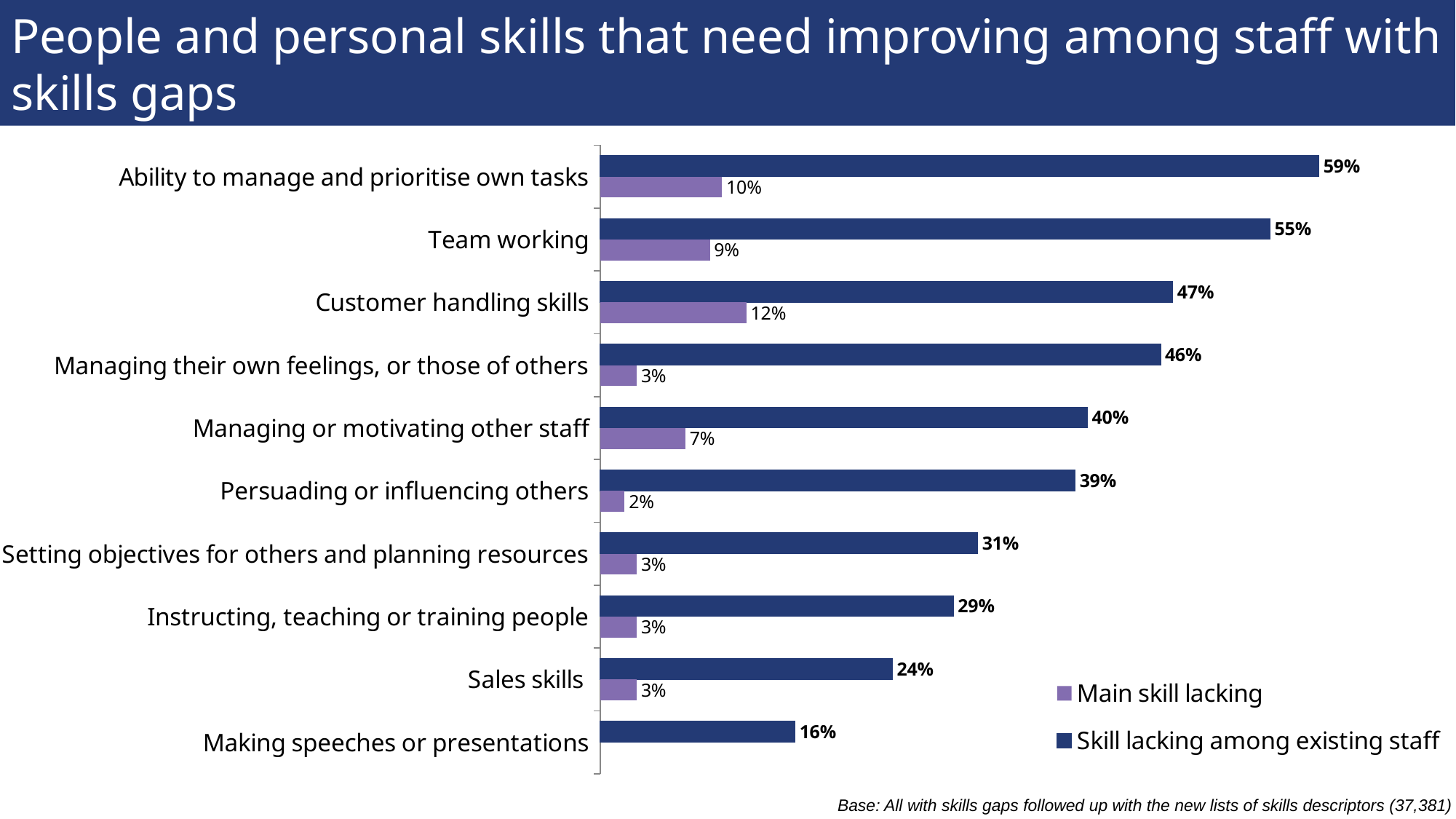
Which category has the highest value for 'Skill lacking among existing staff'? Ability to manage and prioritise own tasks What is the value for 'Skill lacking among existing staff' for Making speeches or presentations? 16% What kind of chart is shown on the slide? Bar chart What is the difference between the 'Skill lacking among existing staff' and 'Main skill lacking' values for Managing or motivating other staff? 33% Which colour represents 'Main skill lacking' in the legend? Purple What is the value for 'Main skill lacking' for Customer handling skills? 12% How many categories are shown on the chart? 10 How many series does the legend list? 2 What is the value for 'Skill lacking among existing staff' for Team working? 55% Which is larger: the 'Main skill lacking' value for Customer handling skills or for Ability to manage and prioritise own tasks? Customer handling skills Which category has the lowest value for 'Main skill lacking' among those with a labelled value? Persuading or influencing others What is the difference between the 'Skill lacking among existing staff' values for Ability to manage and prioritise own tasks and Team working? 4%